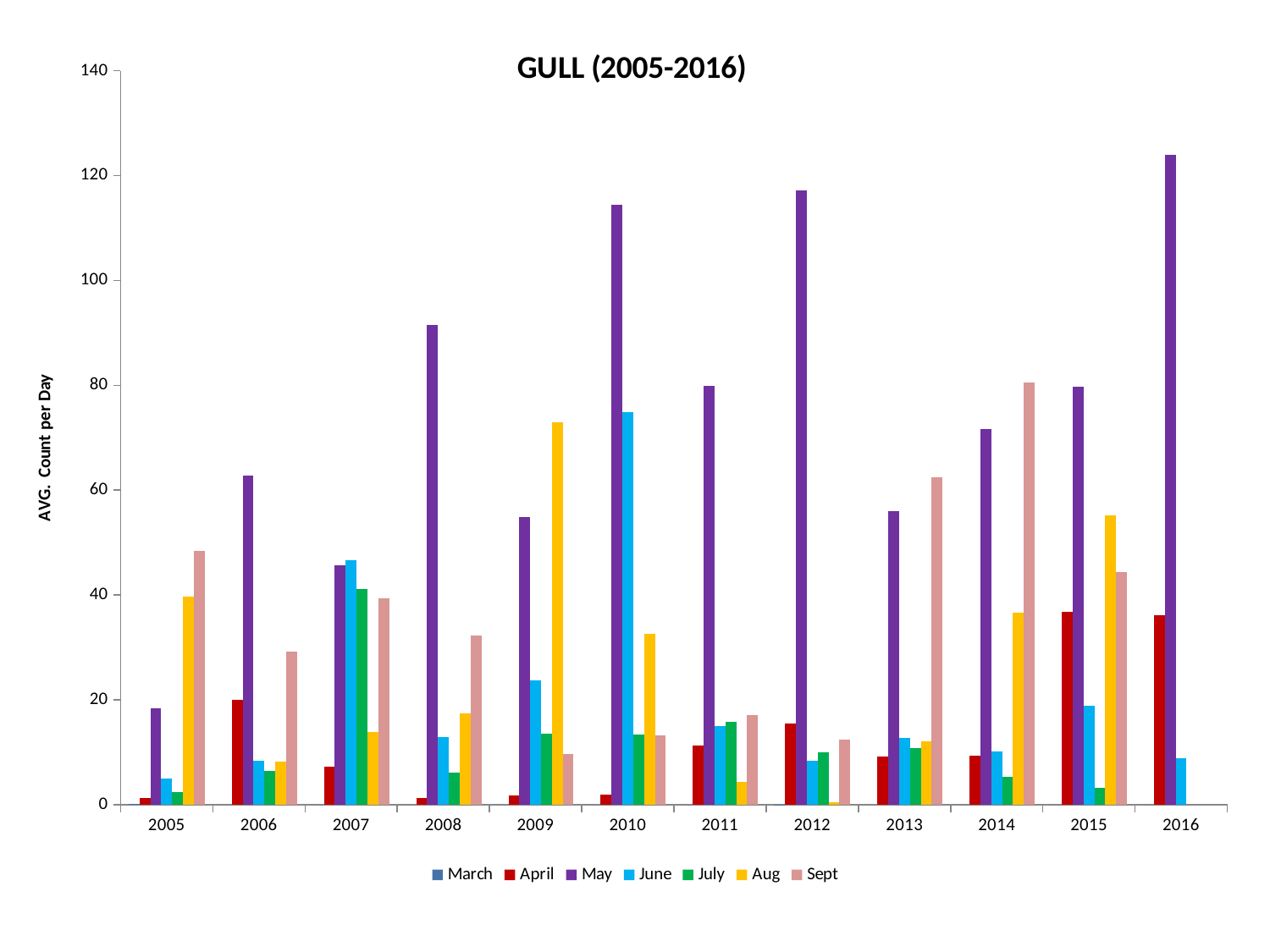
How many series does the legend list? 7 What is the title of the chart? GULL (2005-2016) Is the May value for 2016 greater or less than 120? greater In which year is the Sept value highest? 2014 How many years are shown along the x axis? 12 In which year is the May value highest? 2016 Is the May value for 2008 greater or less than 100? less In which year is the May value lowest? 2005 Is the June value for 2010 greater or less than 60? greater What kind of chart is shown on the slide? bar chart In which year is the Aug value highest? 2009 Which is larger in 2013, the May value or the Sept value? Sept